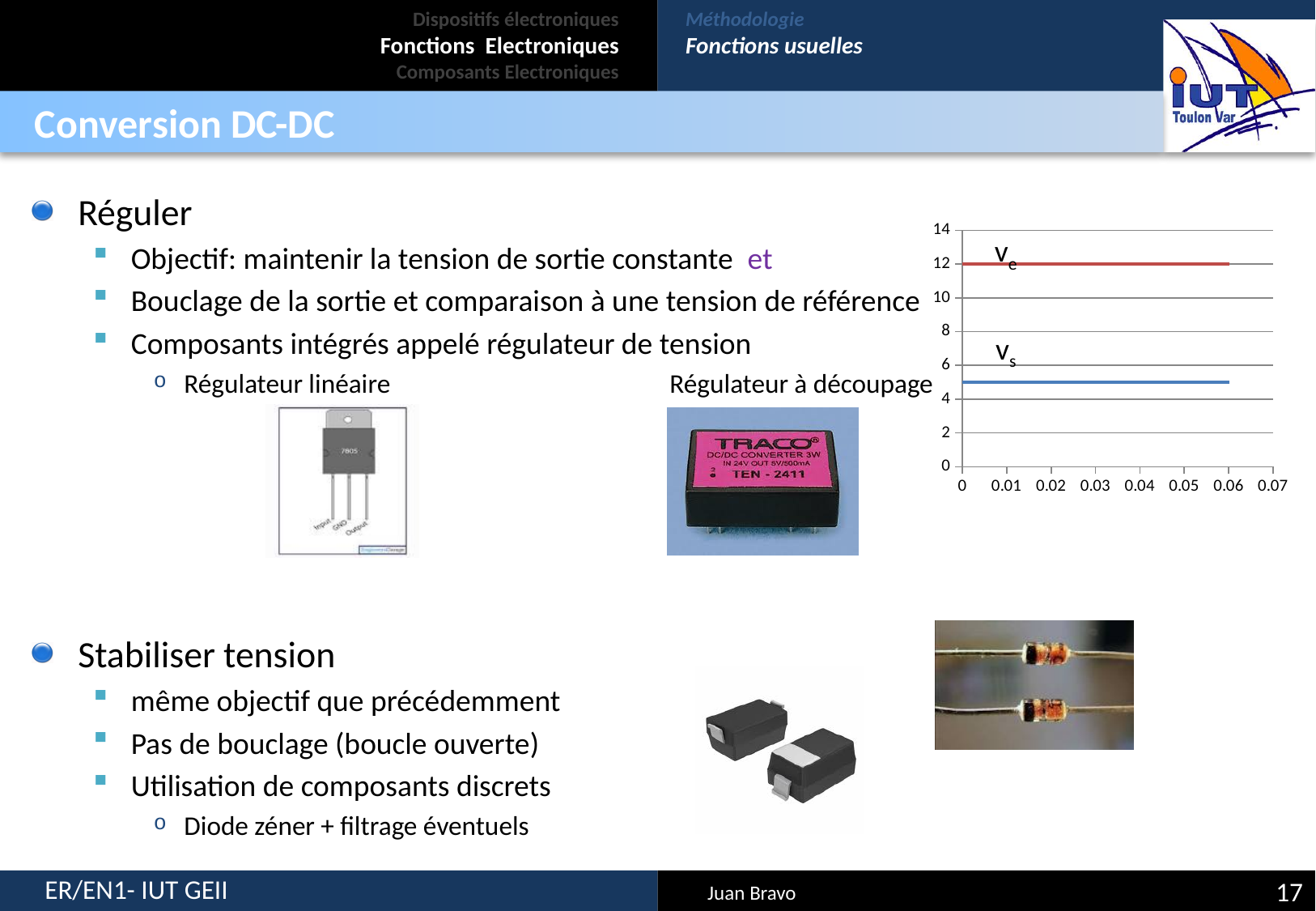
What colour is the Ve line on the chart? red Which of the two plotted lines has the highest value? Ve Is the value of the Vs line greater or less than 6? less What is the maximum value shown on the y axis of the chart? 14 Which of the two plotted lines has the lowest value? Vs Which line is higher on the chart, Ve or Vs? Ve Is the value of the Vs line greater or less than 4? greater Do the values of the Ve line rise, fall or stay constant along the x axis? stay constant What value does the Ve line sit at on the y axis? 12 What kind of chart is shown on the slide? line chart Is the value of the Ve line greater or less than 10? greater How many lines are plotted on the chart? 2